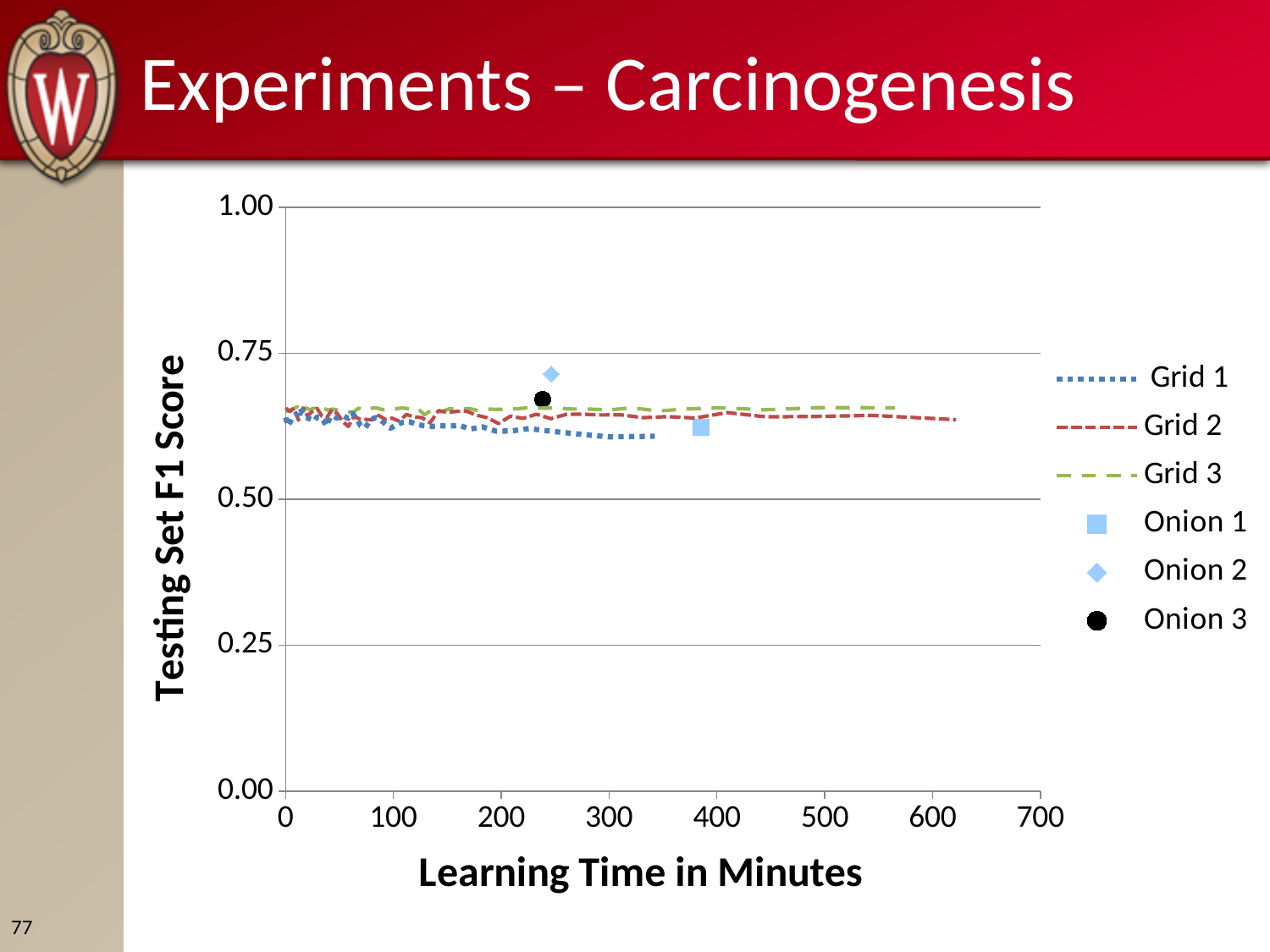
Which Grid series extends to the largest Learning Time in Minutes? Grid 2 Which of the Onion points has the largest Learning Time in Minutes? Onion 1 Is the Testing Set F1 Score for Onion 1 greater or less than 0.75? less How many series does the legend list? 6 Is the Testing Set F1 Score for Onion 2 greater or less than 0.75? less Which has the higher Testing Set F1 Score, Onion 3 or Onion 1? Onion 3 Which of the Onion points has the highest Testing Set F1 Score? Onion 2 What is the title of the y axis? Testing Set F1 Score What is the title of the x axis? Learning Time in Minutes Is the Testing Set F1 Score for Onion 2 greater or less than 0.50? greater Which of the Onion points has the lowest Testing Set F1 Score? Onion 1 What kind of chart is shown on the slide? Line chart with scatter points